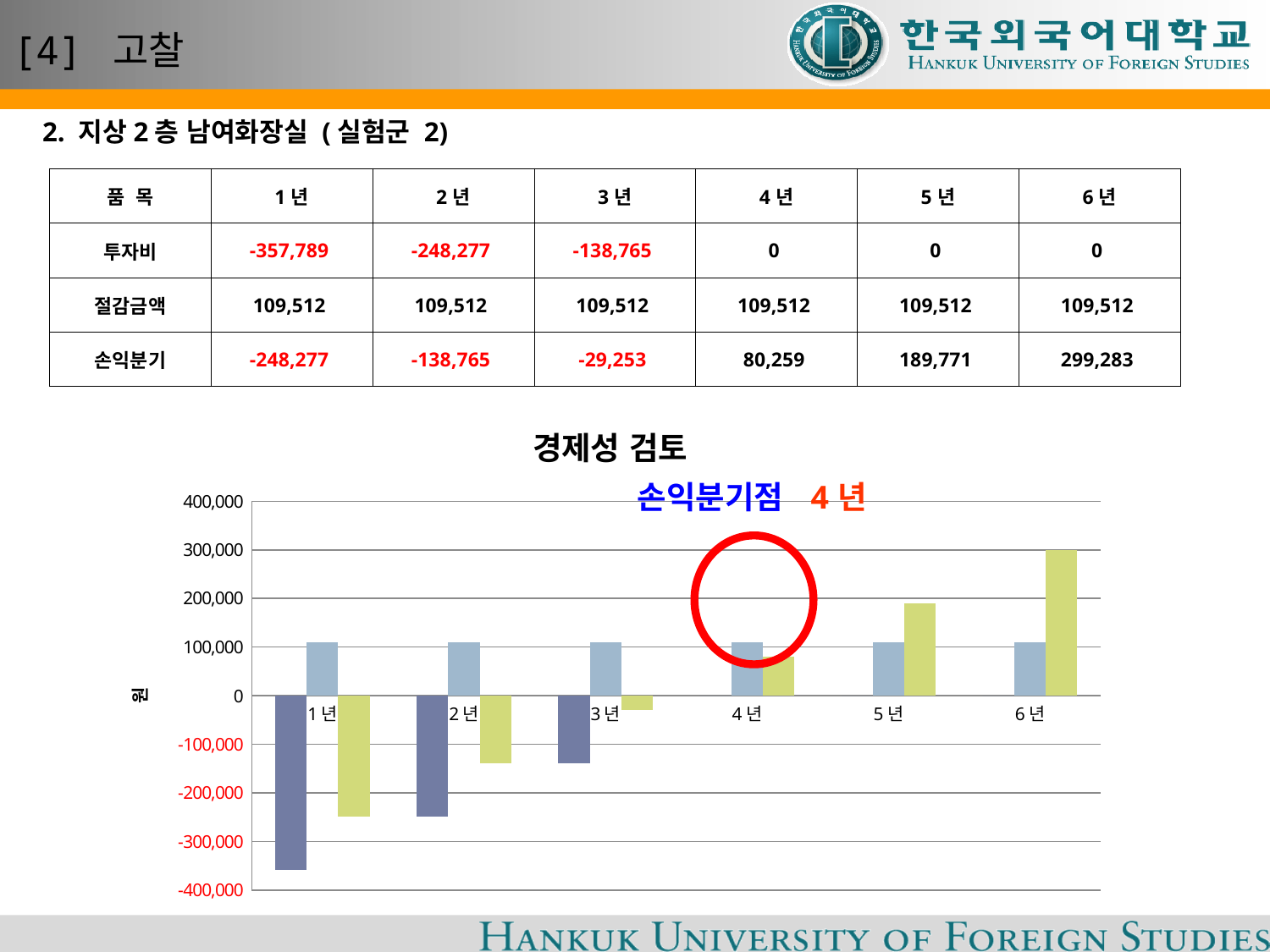
Is the value of the green bar for 2 년 greater or less than -100,000? less Is the value of the green bar for 6 년 greater or less than 200,000? greater What type of chart is shown under the title 경제성 검토? bar chart Which year has the tallest green bar in the chart? 6 년 Is the value of the dark blue bar for 1 년 greater or less than -300,000? less How many year categories are shown on the x axis of the chart? 6 Do the green bars rise or fall from 1 년 to 6 년? rise What label is shown on the vertical axis of the chart? 원 What is the title of the chart on the slide? 경제성 검토 Which year has the lowest dark blue bar in the chart? 1 년